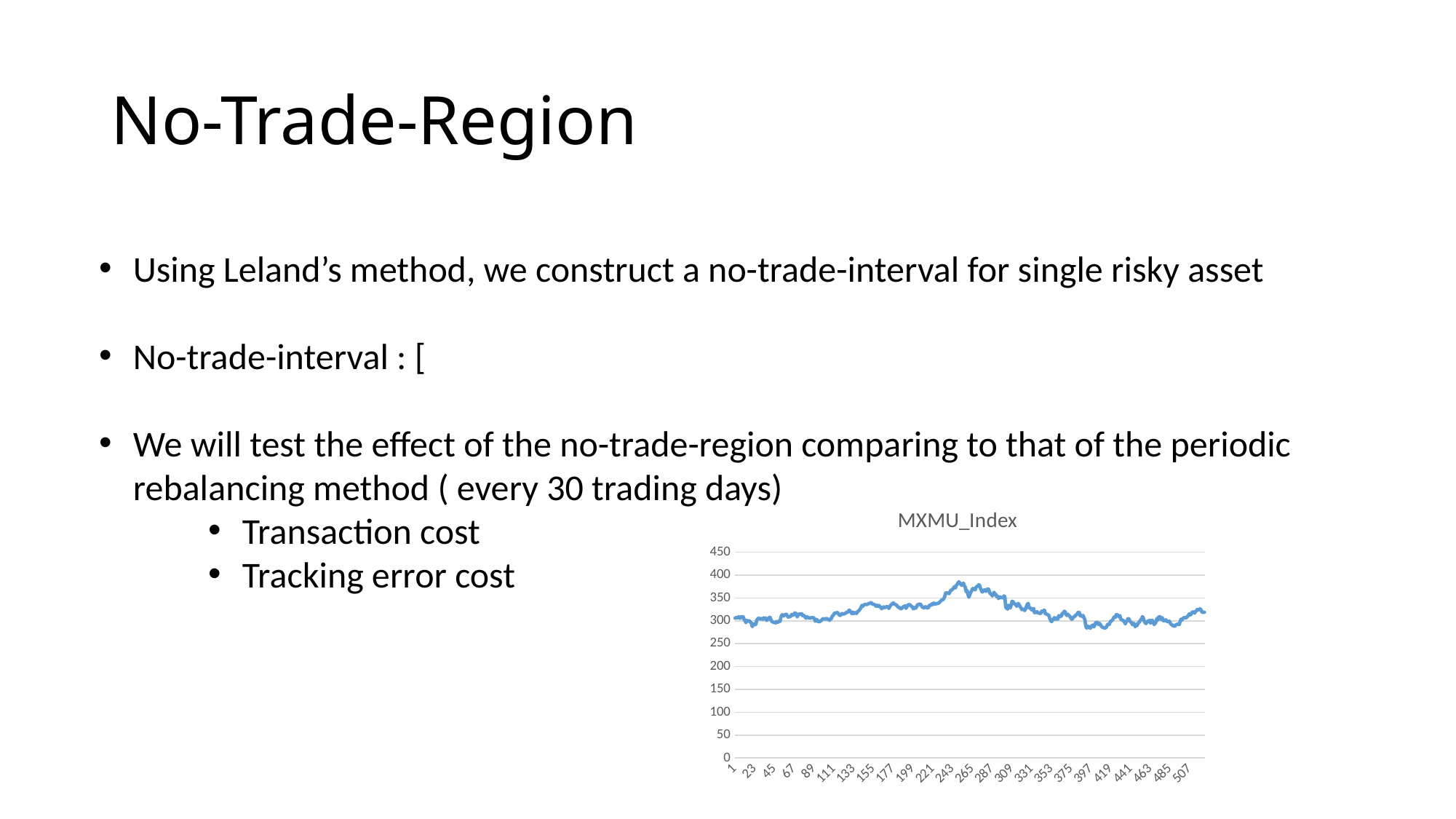
What is the highest value labelled on the y axis of the MXMU_Index chart? 450 What is the last label shown on the x axis of the MXMU_Index chart? 507 In the MXMU_Index chart, does the line ever fall below 250? No In the MXMU_Index chart, does the line rise or fall between x = 265 and x = 397? fall How many lines (series) are plotted in the MXMU_Index chart? 1 What kind of chart is shown on the slide? line chart What is the title of the chart on the slide? MXMU_Index In the MXMU_Index chart, is the value at x = 155 greater or less than 300? greater In the MXMU_Index chart, is the value at x = 155 greater or less than 350? less In the MXMU_Index chart, does the line rise or fall between x = 133 and x = 265? rise